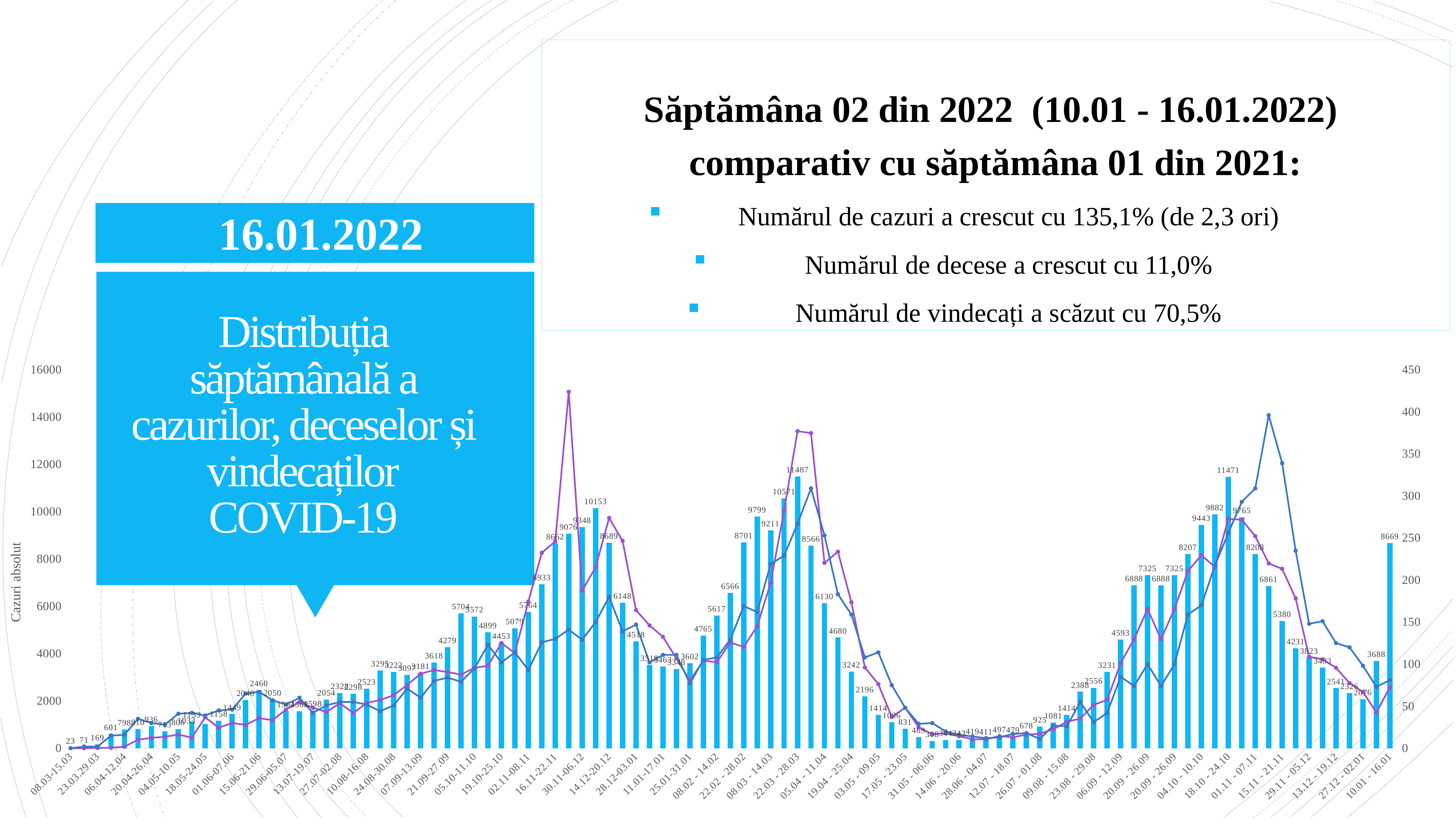
Which bar is larger, the one for 08.03-15.03 or the one for 10.01 - 16.01? 10.01 - 16.01 What is the highest value labelled on the bars? 11487 What is the title of the left vertical axis? Cazuri absolut What is the value of the bar for the week 10.01 - 16.01? 8669 What is the difference between the highest bar value (11487) and the bar for 10.01 - 16.01 (8669)? 2818 What is the value of the bar for the first week, 08.03-15.03? 23 Is the value of the bar for 10.01 - 16.01 greater or less than 8000 on the left axis? greater How many line series are plotted on the chart in addition to the bars? 2 What is the maximum value shown on the left vertical axis? 16000 What is the lowest value labelled on the bars? 23 What kind of chart is shown? A combined bar and line chart Is the highest point of the purple line greater or less than 400 on the right axis? greater